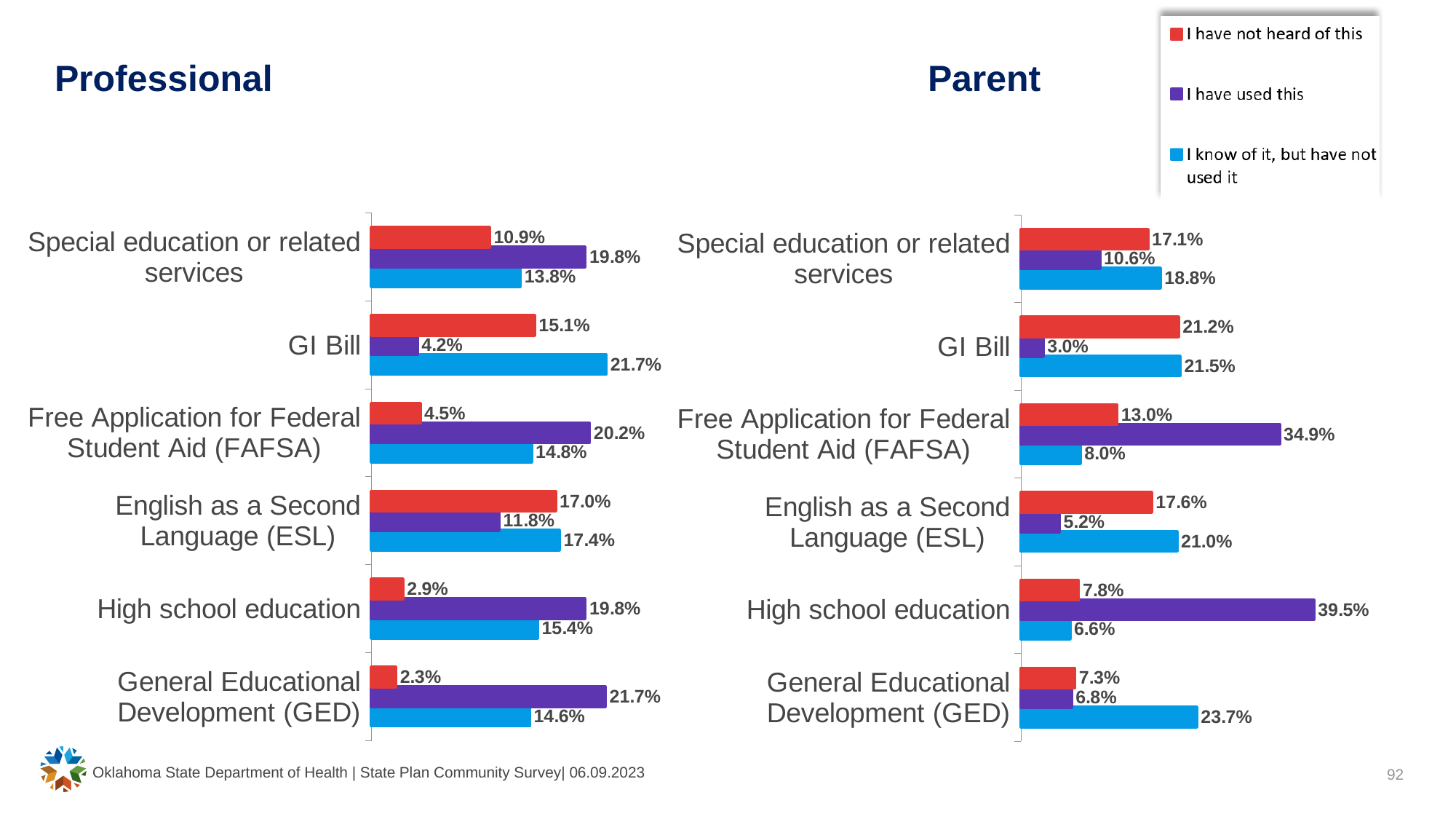
Which colour represents 'I have used this' in the legend? Purple How many series does the legend list? 3 What kind of chart is the Professional chart? Bar chart In the Professional chart, what is the difference between 'I know of it, but have not used it' and 'I have used this' for GI Bill? 17.5% In the Parent chart, which category has the highest value for 'I have used this'? High school education In the Professional chart, what is the value for 'I have used this' for GI Bill? 4.2% In the Parent chart, what is the value for 'I know of it, but have not used it' for General Educational Development (GED)? 23.7% In the Professional chart, which category has the lowest value for 'I have not heard of this'? General Educational Development (GED) How many categories are shown in the Parent chart? 6 In the Professional chart, which is larger for English as a Second Language (ESL): 'I have not heard of this' or 'I have used this'? I have not heard of this In the Parent chart, what is the value for 'I have not heard of this' for Special education or related services? 17.1% In the Parent chart, what is the difference between 'I have used this' and 'I have not heard of this' for Free Application for Federal Student Aid (FAFSA)? 21.9%